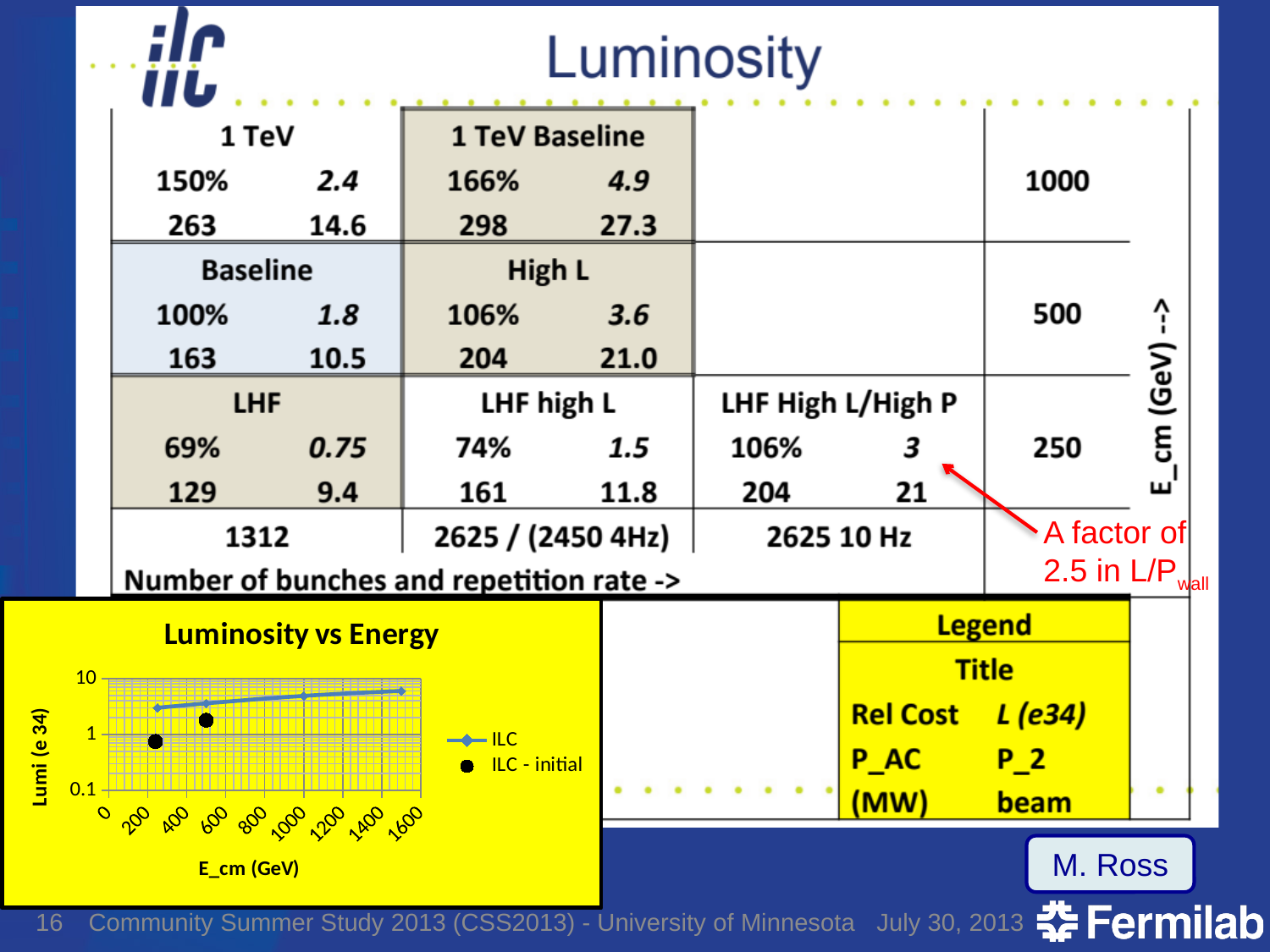
In the Luminosity vs Energy chart, does the ILC series rise or fall as E_cm increases? rise In the Luminosity vs Energy chart, how many points are plotted for the ILC - initial series? 2 In the Luminosity vs Energy chart, how many points are plotted for the ILC series? 4 What is the title of the chart on the slide? Luminosity vs Energy In the Luminosity vs Energy chart, which series has the lowest plotted point? ILC - initial In the Luminosity vs Energy chart, at about 500 GeV, which series has the larger value, ILC or ILC - initial? ILC What is the label of the y axis of the Luminosity vs Energy chart? Lumi (e 34) How many series does the legend of the Luminosity vs Energy chart list? 2 In the Luminosity vs Energy chart, is the ILC value at about 1400 GeV greater or less than 10? less In the Luminosity vs Energy chart, is the ILC - initial value at about 250 GeV greater or less than 1? less In the Luminosity vs Energy chart, is the ILC - initial value at about 500 GeV greater or less than 1? greater What kind of chart is the Luminosity vs Energy chart? line chart